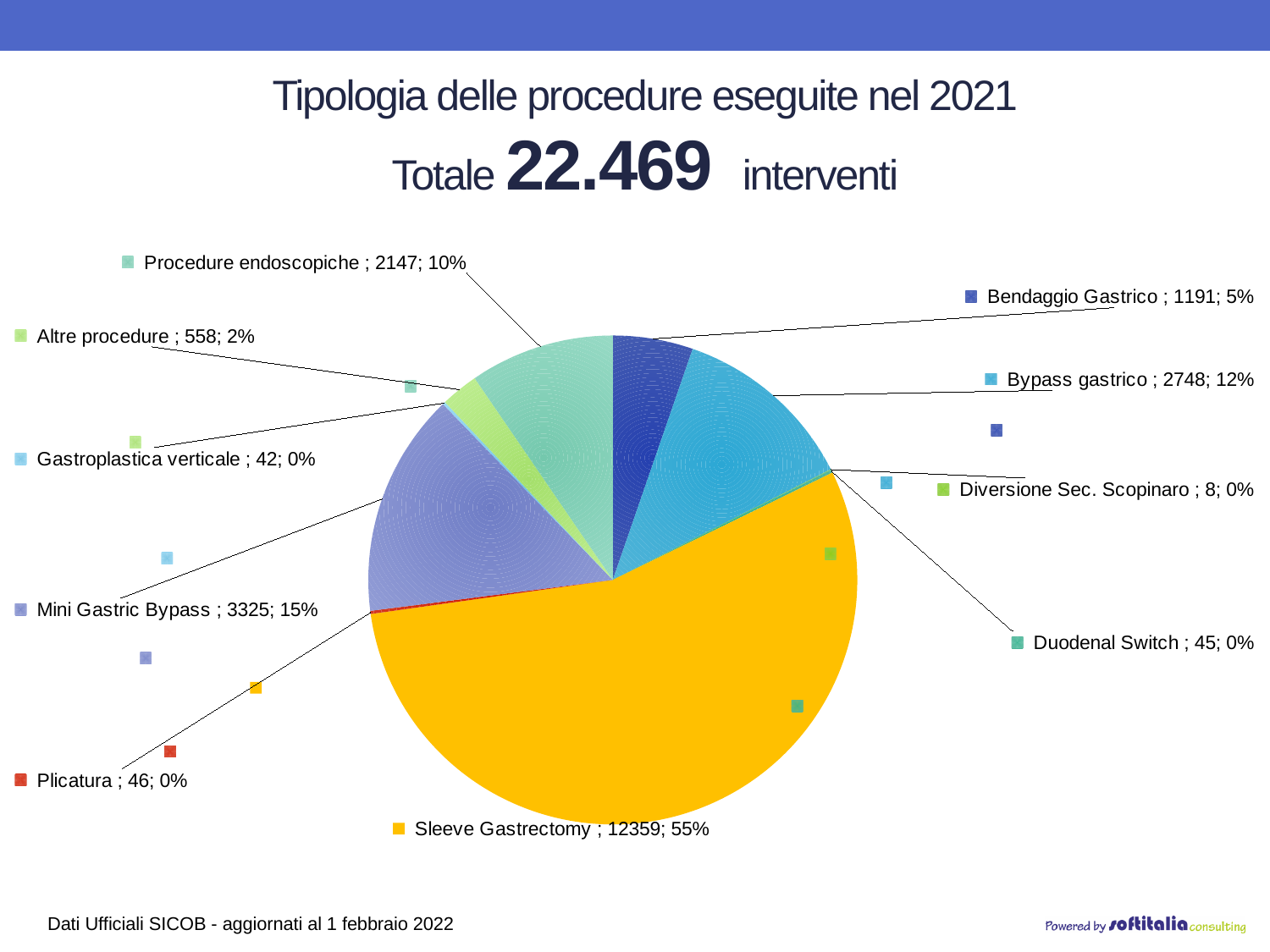
Which category has the smallest value? Diversione Sec. Scopinaro Which is larger, Bendaggio Gastrico or Altre procedure? Bendaggio Gastrico How many procedures are shown for Sleeve Gastrectomy? 12359 What share of the pie does Procedure endoscopiche represent? 10% What is the total number of interventions stated in the slide title? 22.469 What percentage share does Bypass gastrico have? 12% What is the difference between the values for Mini Gastric Bypass and Bypass gastrico? 577 How many categories are shown in the pie chart? 10 Which category has the largest slice of the pie? Sleeve Gastrectomy What kind of chart is shown on the slide? pie chart What is the value for Mini Gastric Bypass? 3325 What is the value for Duodenal Switch? 45